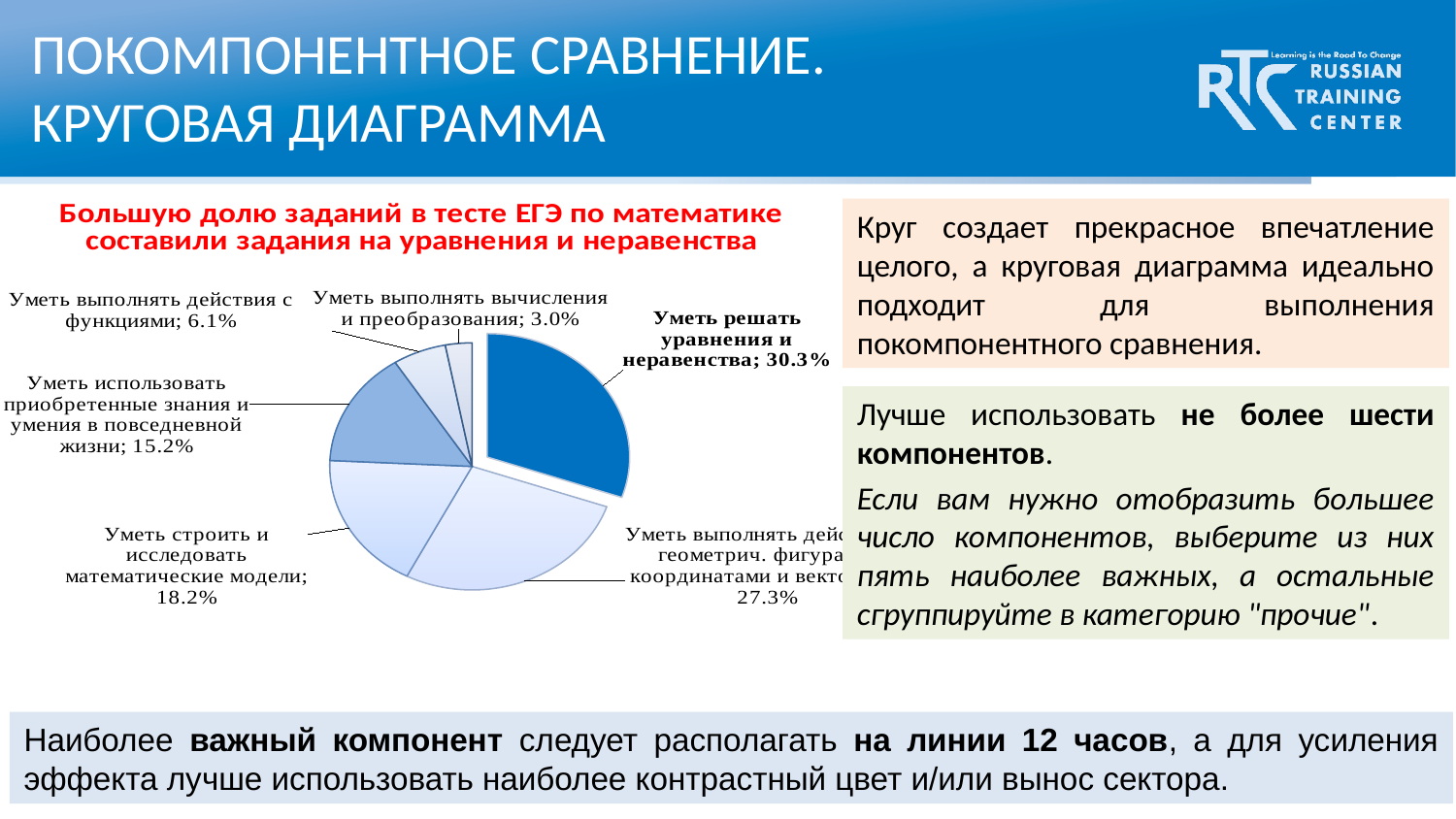
How many slices does the pie chart have? 6 What is the value shown for "Уметь выполнять действия с функциями"? 6.1% Which slice of the pie chart is the largest? Уметь решать уравнения и неравенства Which is larger: the share for "Уметь выполнять действия с функциями" or the share for "Уметь выполнять вычисления и преобразования"? Уметь выполнять действия с функциями What is the difference between the shares for "Уметь решать уравнения и неравенства" and "Уметь строить и исследовать математические модели"? 12.1% What is the value shown for "Уметь строить и исследовать математические модели"? 18.2% What share of the pie is labelled "Уметь решать уравнения и неравенства"? 30.3% Which slice of the pie chart is pulled out (exploded) from the rest of the pie? Уметь решать уравнения и неравенства What kind of chart is shown on the slide? pie chart What is the value shown for "Уметь использовать приобретенные знания и умения в повседневной жизни"? 15.2% What is the difference between the shares for "Уметь использовать приобретенные знания и умения в повседневной жизни" and "Уметь выполнять действия с функциями"? 9.1% Which slice of the pie chart is the smallest? Уметь выполнять вычисления и преобразования